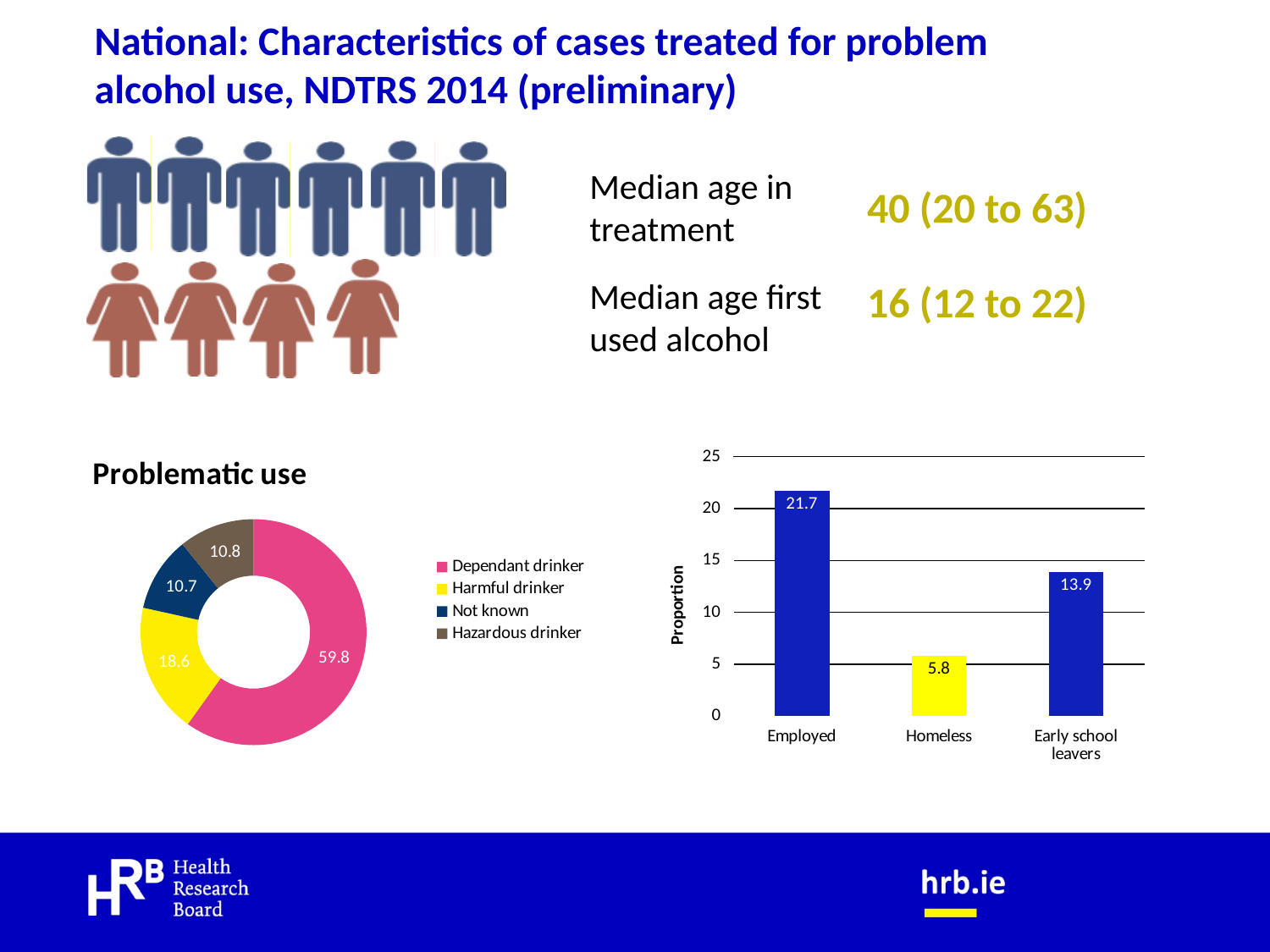
In the 'Problematic use' chart, what is the value for Harmful drinker? 18.6 In the 'Problematic use' chart, what is the value for Dependant drinker? 59.8 In the bar chart on the right, what is the difference between Employed and Early school leavers? 7.8 In the 'Problematic use' chart, what is the difference between the Dependant drinker and Harmful drinker values? 41.2 In the bar chart on the right, what is the value for Employed? 21.7 What kind of chart is the 'Problematic use' chart? Doughnut chart In the 'Problematic use' chart, how many categories does the legend list? 4 In the bar chart on the right, what is the label of the vertical axis? Proportion In the bar chart on the right, which is larger: Early school leavers or Homeless? Early school leavers In the 'Problematic use' chart, which category has the largest share? Dependant drinker In the bar chart on the right, which category has the lowest value? Homeless In the bar chart on the right, what is the value for Homeless? 5.8